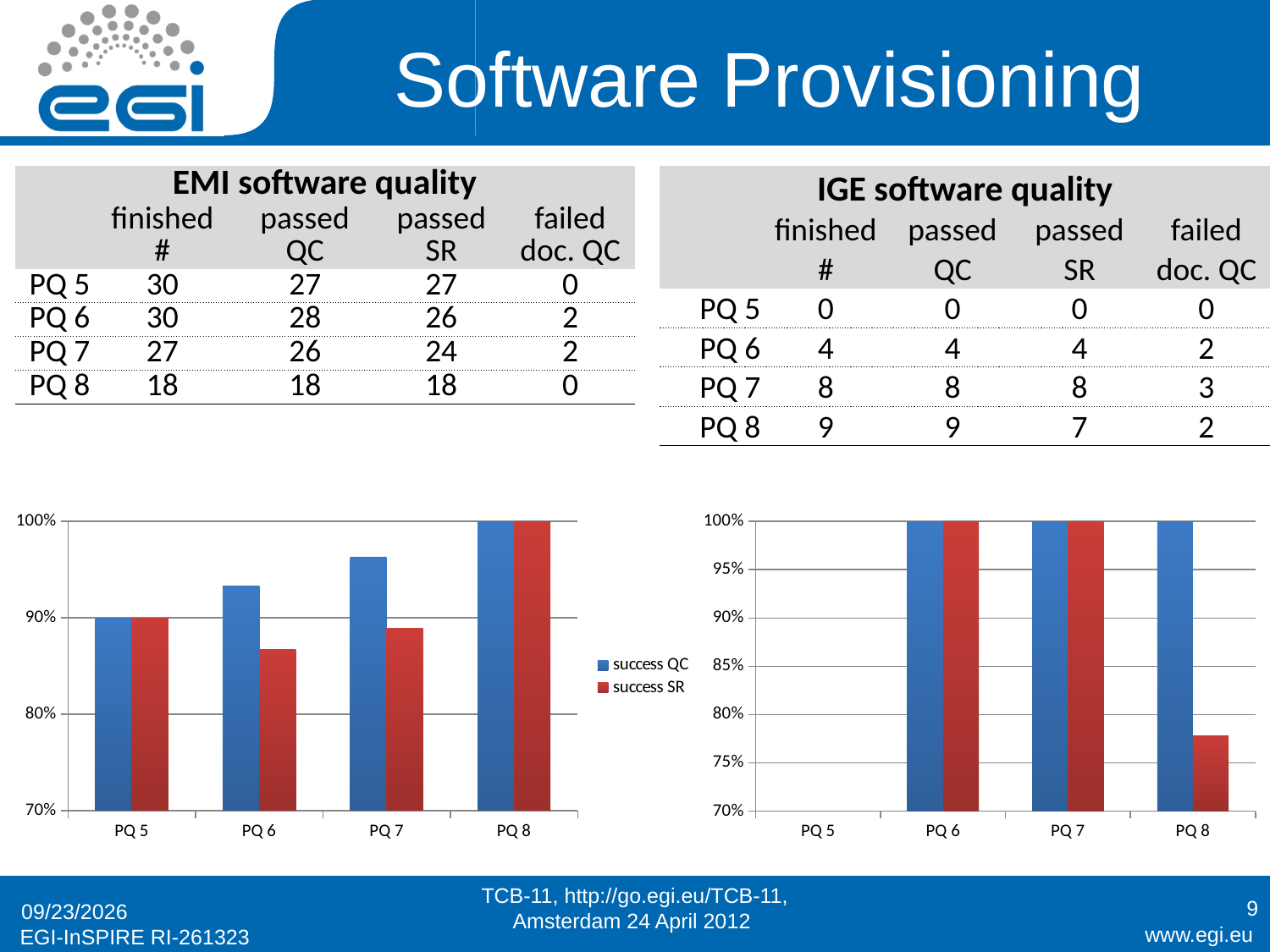
In the left chart, does the success QC series rise or fall from PQ 5 to PQ 8? rises In the left chart, for PQ 7, which is larger: success QC or success SR? success QC In the left chart, what is the success SR value for PQ 5? 90% What kind of chart is the chart on the left of the slide? bar chart How many series does the legend of the left chart list? 2 In the right chart, which category on the x axis has no bars plotted? PQ 5 In the left chart, is the success SR value for PQ 6 greater or less than 90%? less In the left chart, is the success QC value for PQ 7 greater or less than 90%? greater In the right chart, is the value of the red bar for PQ 8 greater or less than 80%? less How many categories are shown on the x axis of the left chart? 4 In the right chart, what is the value of the blue bar for PQ 6? 100% In the left chart, what is the success QC value for PQ 8? 100%